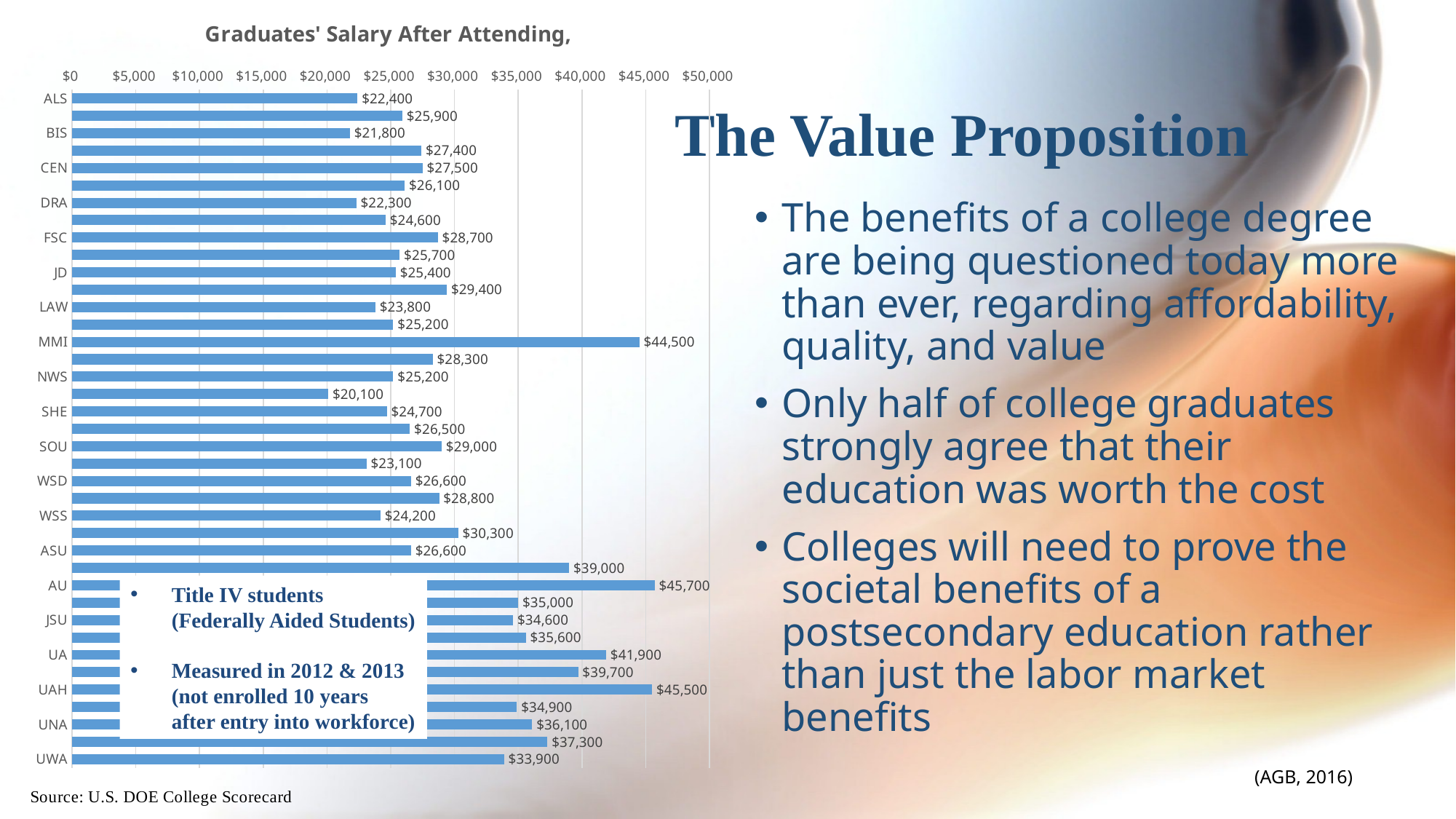
What is the graduates' salary value shown for FSC? $28,700 Is the salary value for JSU greater or less than $30,000? greater What is the difference between the salary values for MMI and ALS? $22,100 What kind of chart is shown on the slide? Bar chart What is the difference between the salary values for AU and UAH? $200 What is the graduates' salary value shown for UA? $41,900 Which has a higher graduates' salary, CEN or DRA? CEN Which labeled institution has the highest graduates' salary on the chart? AU What source is cited for the chart data? U.S. DOE College Scorecard What is the title of the chart? Graduates' Salary After Attending, What is the graduates' salary value shown for UWA? $33,900 What is the graduates' salary value shown for MMI? $44,500